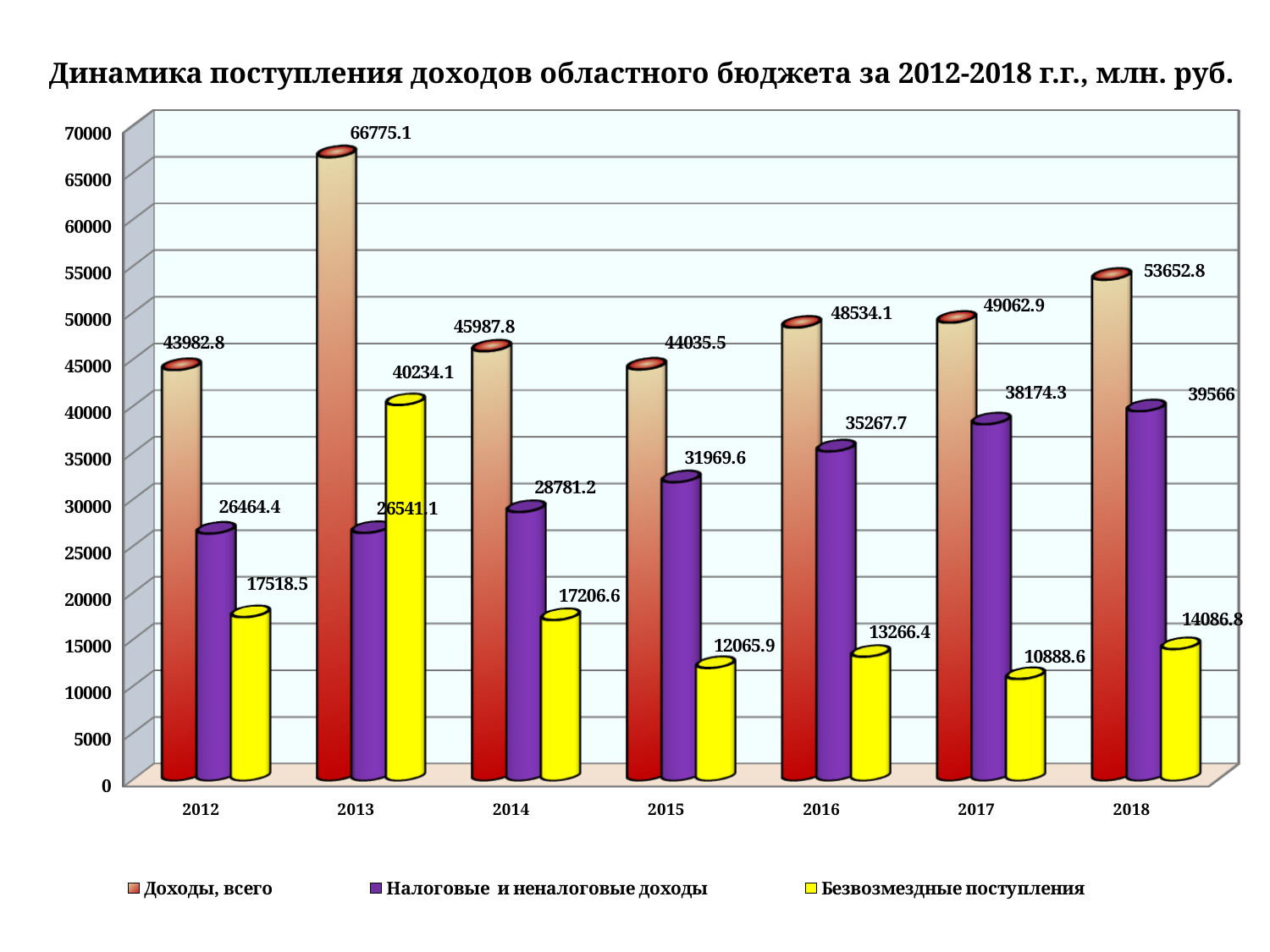
Do the values of Налоговые и неналоговые доходы rise or fall from 2012 to 2018? rise In which year is Доходы, всего the highest? 2013 What kind of chart is shown on the slide? bar chart Is the value of Доходы, всего for 2018 greater or less than 50000? greater How many series does the legend list? 3 In which year is Безвозмездные поступления the lowest? 2017 What is the value of Доходы, всего for 2013? 66775.1 What is the value of Налоговые и неналоговые доходы for 2016? 35267.7 Which is larger: Налоговые и неналоговые доходы in 2018 or Безвозмездные поступления in 2013? Безвозмездные поступления in 2013 How many years are shown on the x axis? 7 What is the difference between Доходы, всего in 2013 and in 2012? 22792.3 What is the value of Безвозмездные поступления for 2017? 10888.6